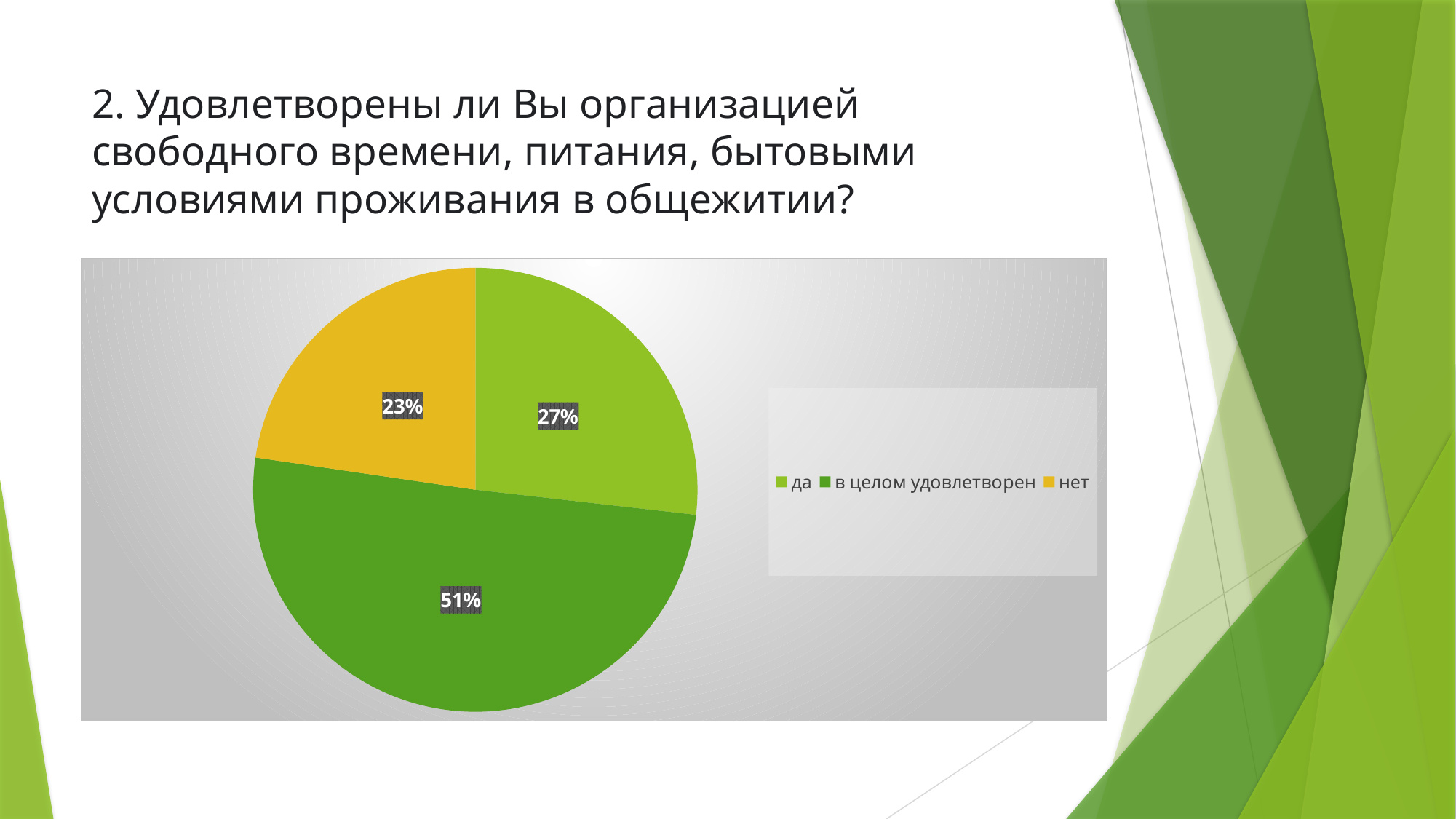
How many slices does the pie chart have? 3 Which answer has the largest share of the pie? в целом удовлетворен What percentage of respondents answered "в целом удовлетворен"? 51% Which is larger, the share for "да" or the share for "нет"? да What kind of chart is shown on the slide? pie chart How many entries does the legend list? 3 What percentage of respondents answered "да"? 27% Which answer has the smallest share of the pie? нет What percentage of respondents answered "нет"? 23% What is the difference in percentage points between "в целом удовлетворен" and "да"? 24 What colour is the slice for "нет"? yellow What is the difference in percentage points between "да" and "нет"? 4